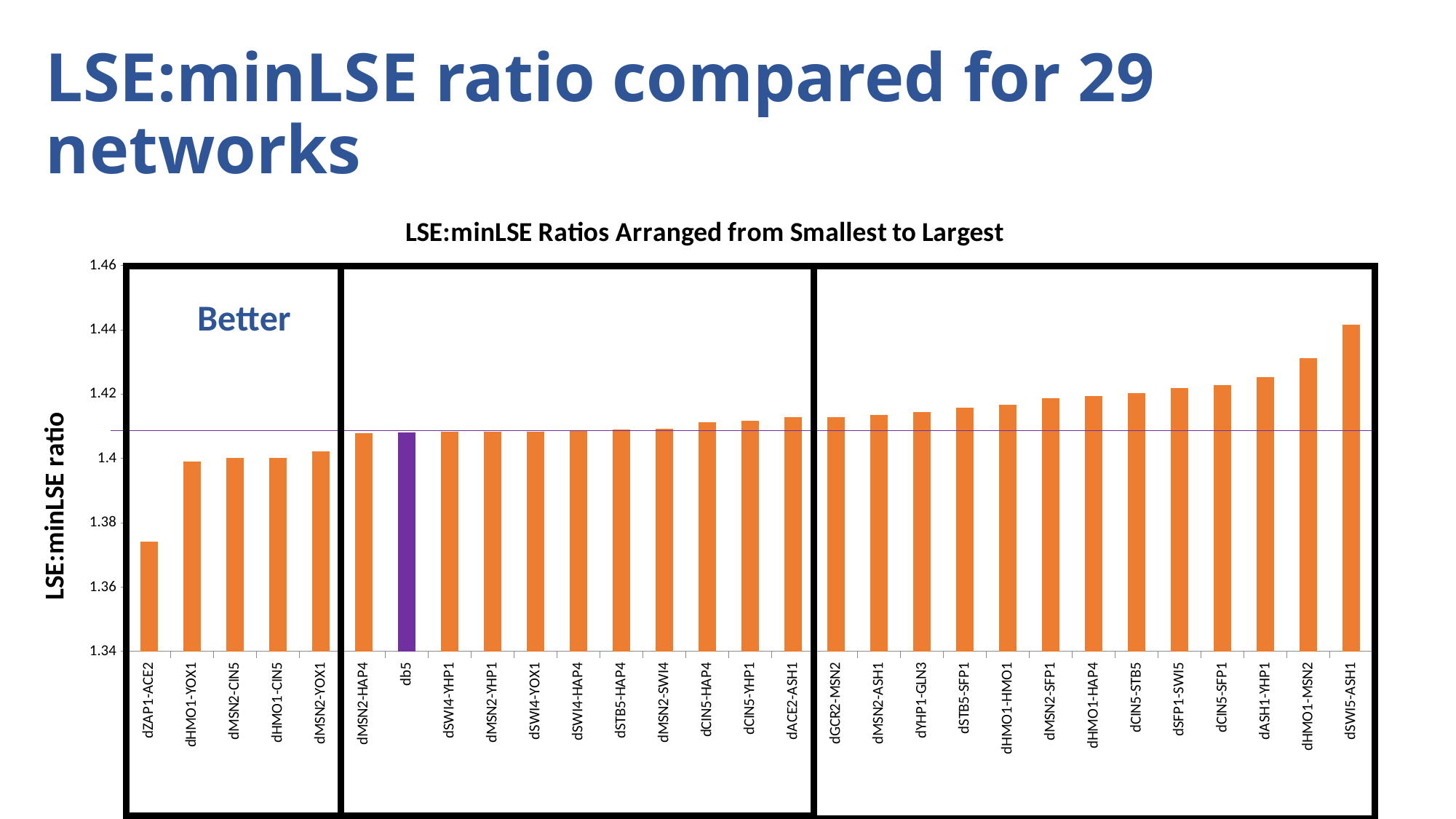
Which network has the highest LSE:minLSE ratio? dSWI5-ASH1 Which has the larger LSE:minLSE ratio, dSWI5-ASH1 or dHMO1-MSN2? dSWI5-ASH1 Is the value for dZAP1-ACE2 greater or less than 1.38? less Is the value for dHMO1-MSN2 greater or less than 1.42? greater Is the value for dSWI5-ASH1 greater or less than 1.42? greater Which network has the lowest LSE:minLSE ratio? dZAP1-ACE2 Do the values rise or fall moving from left to right along the x axis? rise How many networks (bars) are plotted in the chart? 29 Which bar is coloured purple instead of orange? db5 What is the title of the chart? LSE:minLSE Ratios Arranged from Smallest to Largest What kind of chart is shown on the slide? bar chart